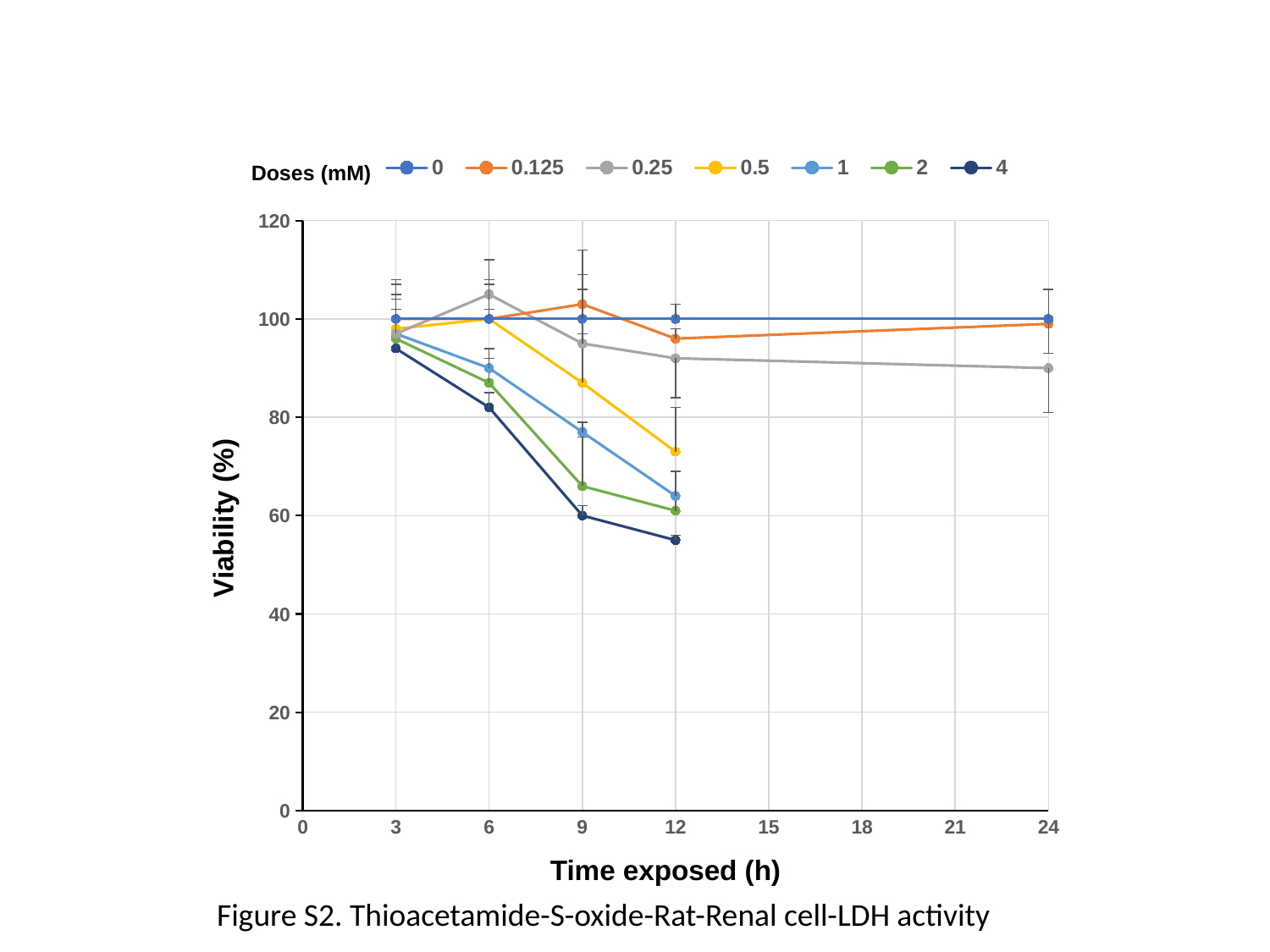
What is the title of the legend? Doses (mM) At 12 h, which dose has the higher viability, 0.5 mM or 2 mM? 0.5 mM Is the viability for the 4 mM dose at 12 h greater or less than 60? less Is the viability for the 0.25 mM dose at 24 h greater or less than 80? greater Is the viability for the 0.5 mM dose at 12 h greater or less than 80? less What is the label of the x axis? Time exposed (h) What is the viability value for the 0 mM dose at 24 h? 100 Does the viability for the 4 mM dose rise or fall from 3 h to 12 h? fall At 12 h, which dose has the lowest viability? 4 mM How many dose series does the legend list? 7 What kind of chart is shown on the slide? line chart